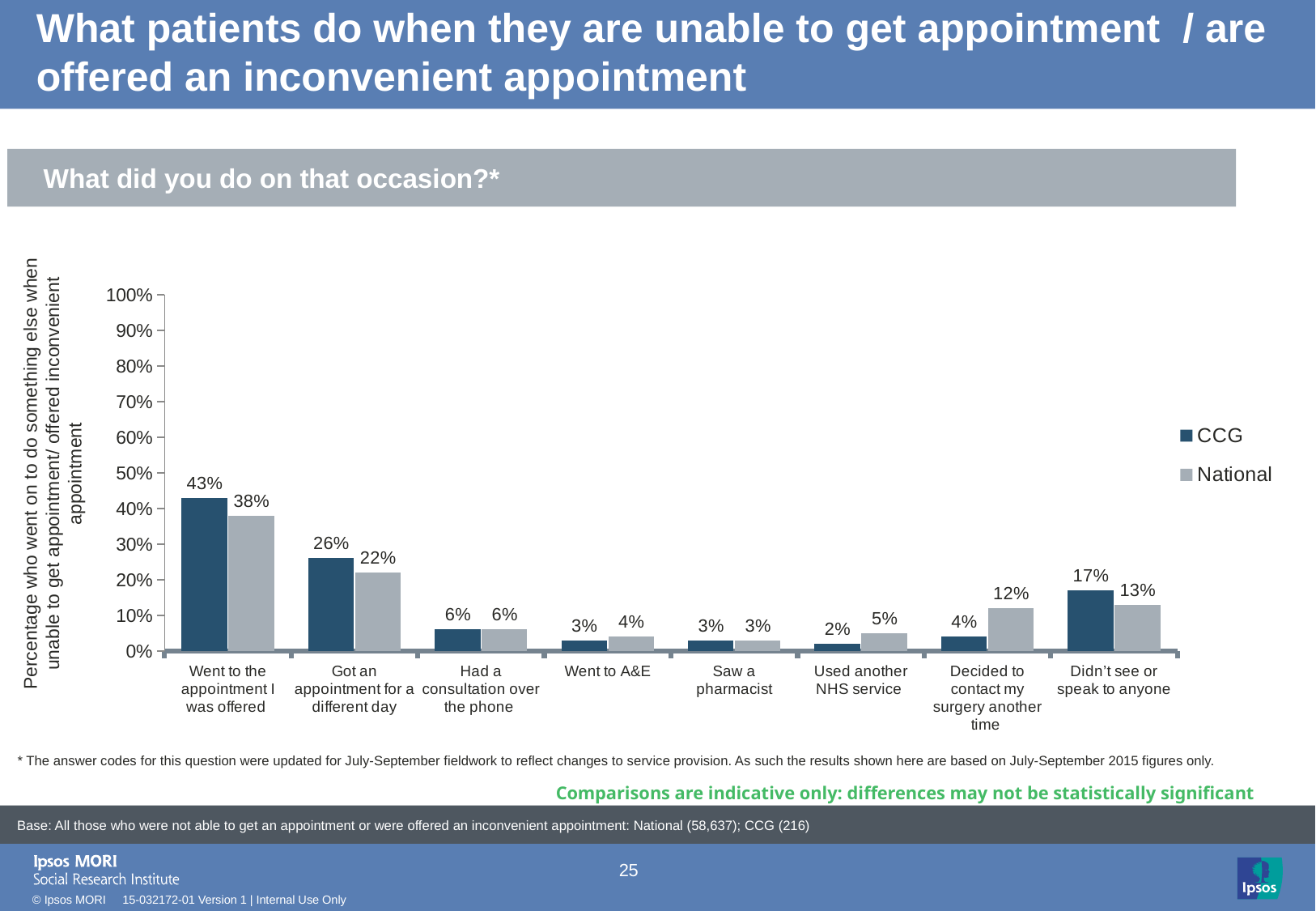
How many series does the legend list? 2 How many categories are shown on the x axis? 8 What is the National value for 'Decided to contact my surgery another time'? 12% Which category has the highest CCG value? Went to the appointment I was offered Which category has the lowest CCG value? Used another NHS service Which is larger for 'Didn't see or speak to anyone', the CCG value or the National value? CCG What is the difference between the CCG and National values for 'Went to the appointment I was offered'? 5% What kind of chart is shown on the slide? Bar chart What is the National value for 'Got an appointment for a different day'? 22% What is the difference between the CCG and National values for 'Used another NHS service'? 3% Which is larger for 'Decided to contact my surgery another time', the CCG value or the National value? National What is the CCG value for 'Went to the appointment I was offered'? 43%